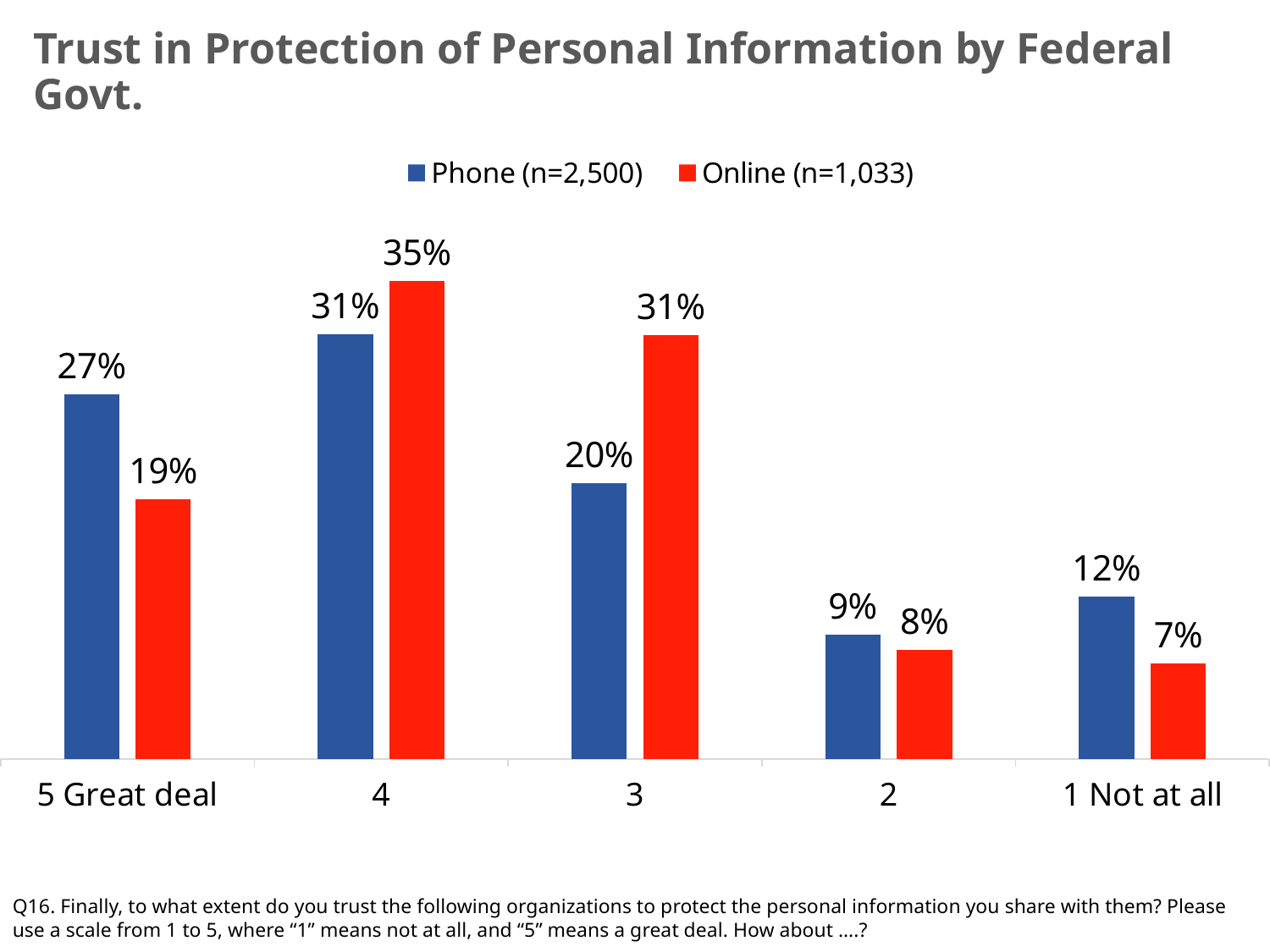
Which category has the lowest Phone value? 2 What is the Online value for the "4" category? 35% How many series does the legend list? 2 What is the Phone value for the "1 Not at all" category? 12% What is the Phone value for the "5 Great deal" category? 27% How many categories are shown on the x axis? 5 Which category has the highest Online value? 4 What is the difference between the Phone and Online values for the "3" category? 11% What is the sample size shown in the legend for the Online series? n=1,033 What kind of chart is shown on the slide? Bar chart Which is larger for the "5 Great deal" category, the Phone value or the Online value? Phone What colour are the bars for the Phone series? Blue